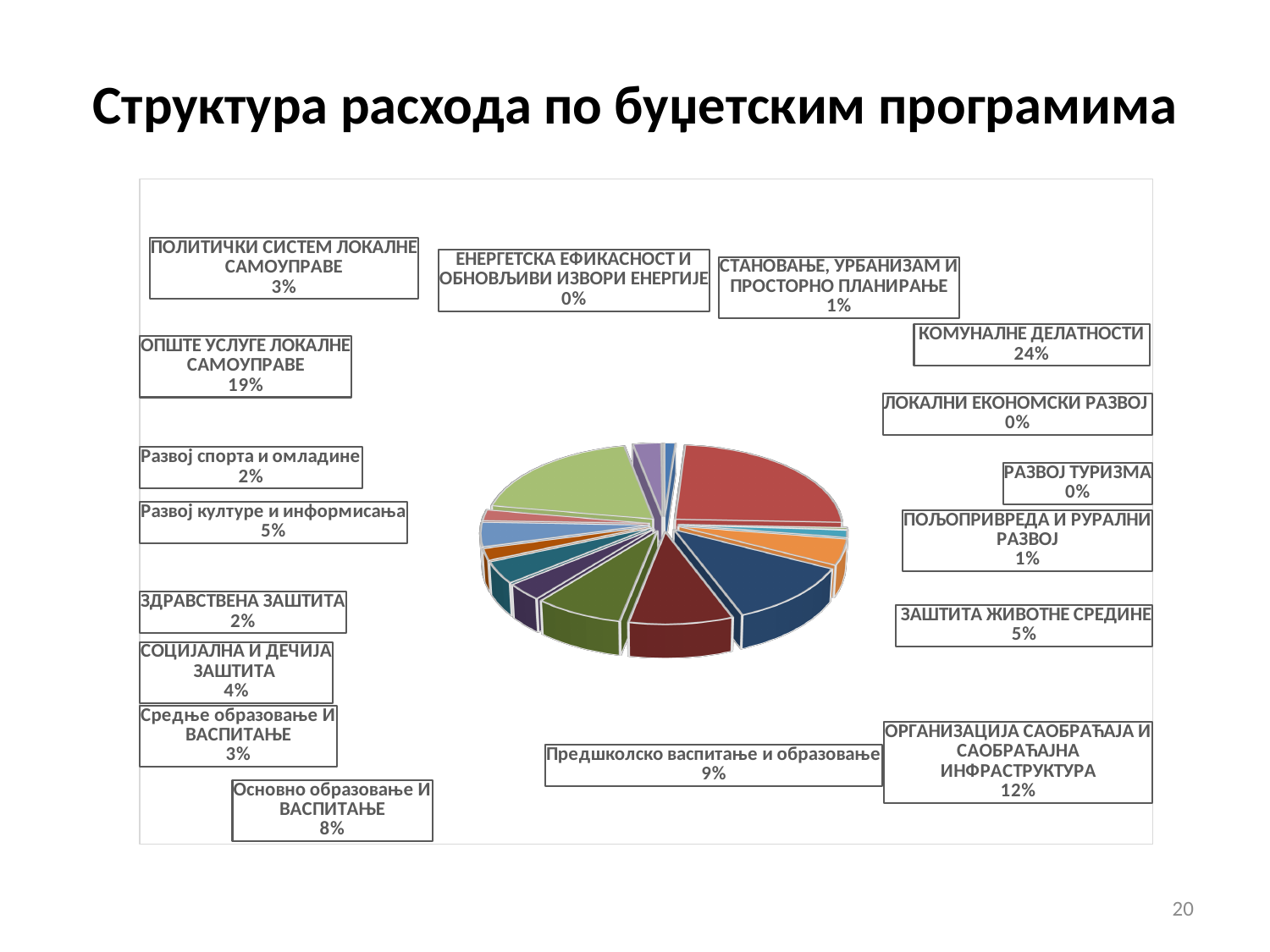
What is the difference in percentage points between КОМУНАЛНЕ ДЕЛАТНОСТИ and ОПШТЕ УСЛУГЕ ЛОКАЛНЕ САМОУПРАВЕ? 5 percentage points What percentage is shown for СОЦИЈАЛНА И ДЕЧИЈА ЗАШТИТА? 4% What percentage is shown for ОРГАНИЗАЦИЈА САОБРАЋАЈА И САОБРАЋАЈНА ИНФРАСТРУКТУРА? 12% Which category has the largest share of the pie? КОМУНАЛНЕ ДЕЛАТНОСТИ What percentage is shown for Основно образовање И ВАСПИТАЊЕ? 8% What share of the pie does ОПШТЕ УСЛУГЕ ЛОКАЛНЕ САМОУПРАВЕ have? 19% What percentage is shown for Предшколско васпитање и образовање? 9% How many categories are labelled on the pie chart? 17 What kind of chart is shown on the slide? pie chart Which has a larger share: Предшколско васпитање и образовање or Основно образовање И ВАСПИТАЊЕ? Предшколско васпитање и образовање What is the title of the slide? Структура расхода по буџетским програмима What share of the pie does КОМУНАЛНЕ ДЕЛАТНОСТИ have? 24%